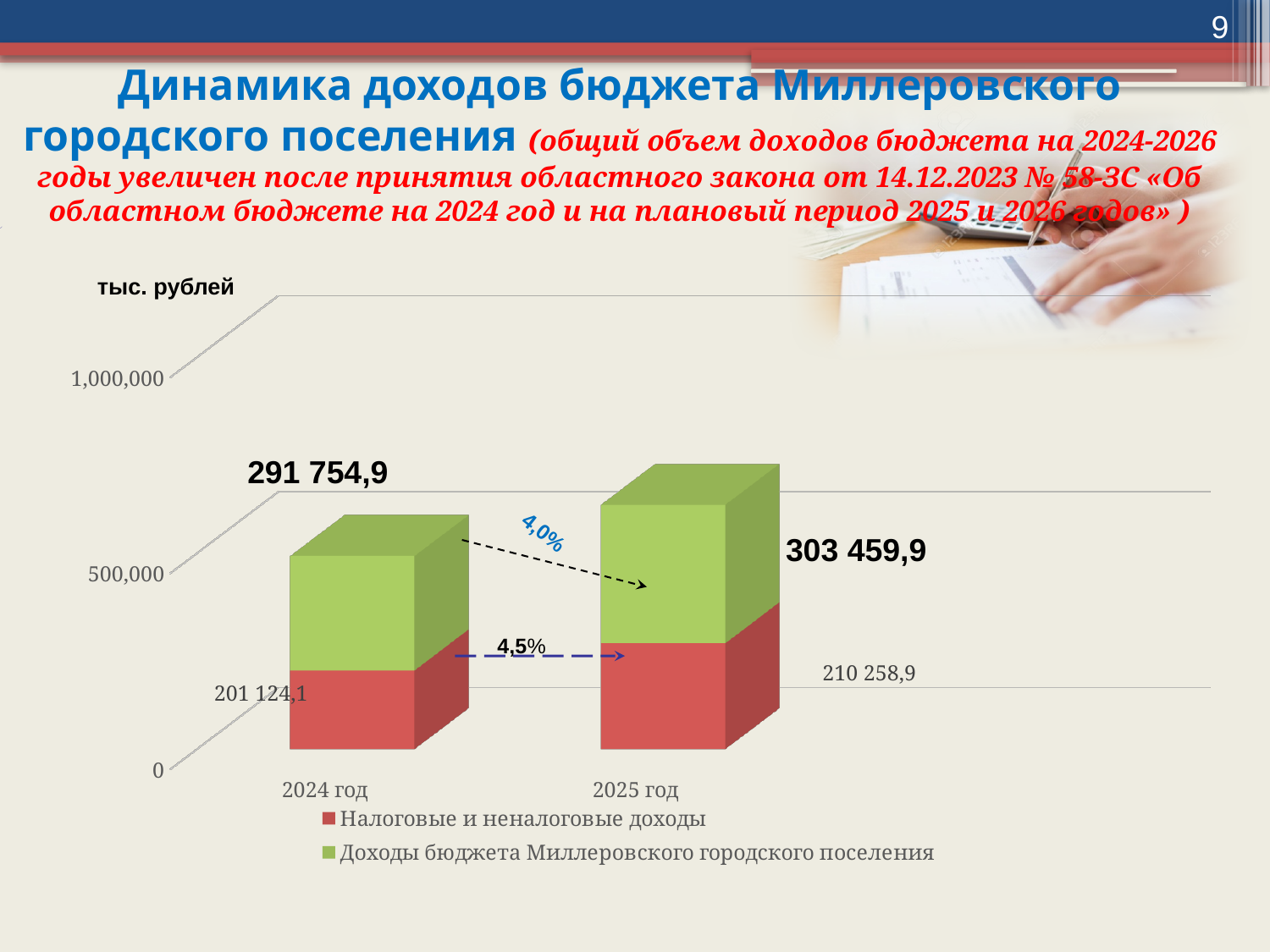
What is the value of Налоговые и неналоговые доходы for 2024 год? 201 124,1 What is the value of Налоговые и неналоговые доходы for 2025 год? 210 258,9 What unit is stated above the vertical axis of the chart? тыс. рублей What is the value of Доходы бюджета Миллеровского городского поселения for 2024 год? 291 754,9 Do the values of Налоговые и неналоговые доходы rise or fall from 2024 год to 2025 год? rise What is the difference between the Налоговые и неналоговые доходы values for 2025 год and 2024 год? 9 134,8 How many categories are shown on the x axis? 2 Which year has the higher value for Доходы бюджета Миллеровского городского поселения, 2024 год or 2025 год? 2025 год What is the value of Доходы бюджета Миллеровского городского поселения for 2025 год? 303 459,9 What is the difference between the Доходы бюджета Миллеровского городского поселения values for 2025 год and 2024 год? 11 705,0 What kind of chart is shown on the slide? stacked bar chart How many series does the legend list? 2